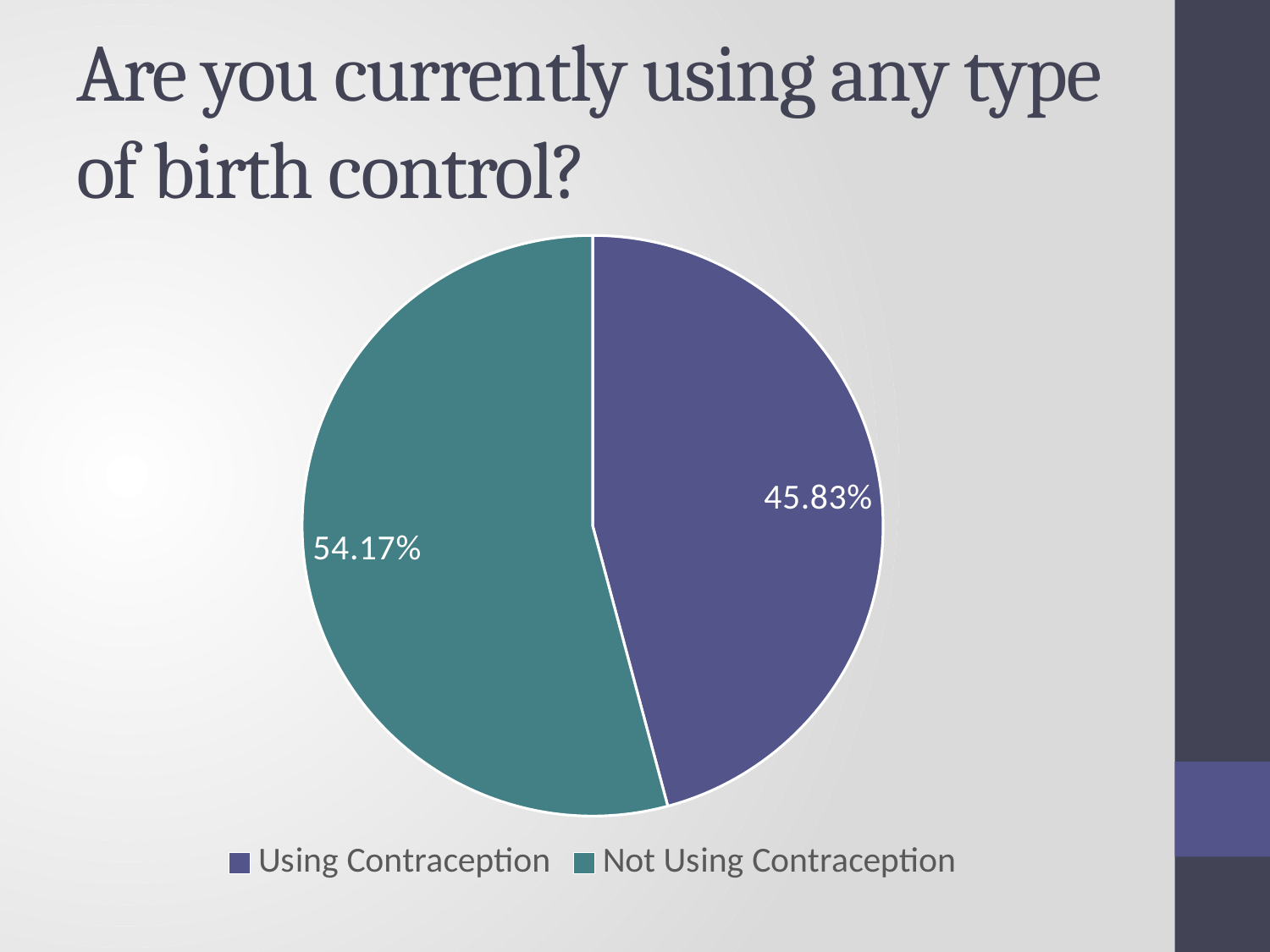
How many slices does the pie chart have? 2 How many entries does the legend list? 2 Which category has the smaller share of the pie? Using Contraception Is the share for Using Contraception greater or less than 50%? less What is the title of the slide containing the pie chart? Are you currently using any type of birth control? What percentage of respondents are Not Using Contraception? 54.17% What kind of chart is shown on the slide? pie chart What percentage of respondents are Using Contraception? 45.83% Which category has the larger share of the pie? Not Using Contraception Is the share for Not Using Contraception larger or smaller than the share for Using Contraception? larger Which legend entry is shown in teal/green? Not Using Contraception What is the difference in percentage points between Not Using Contraception and Using Contraception? 8.34